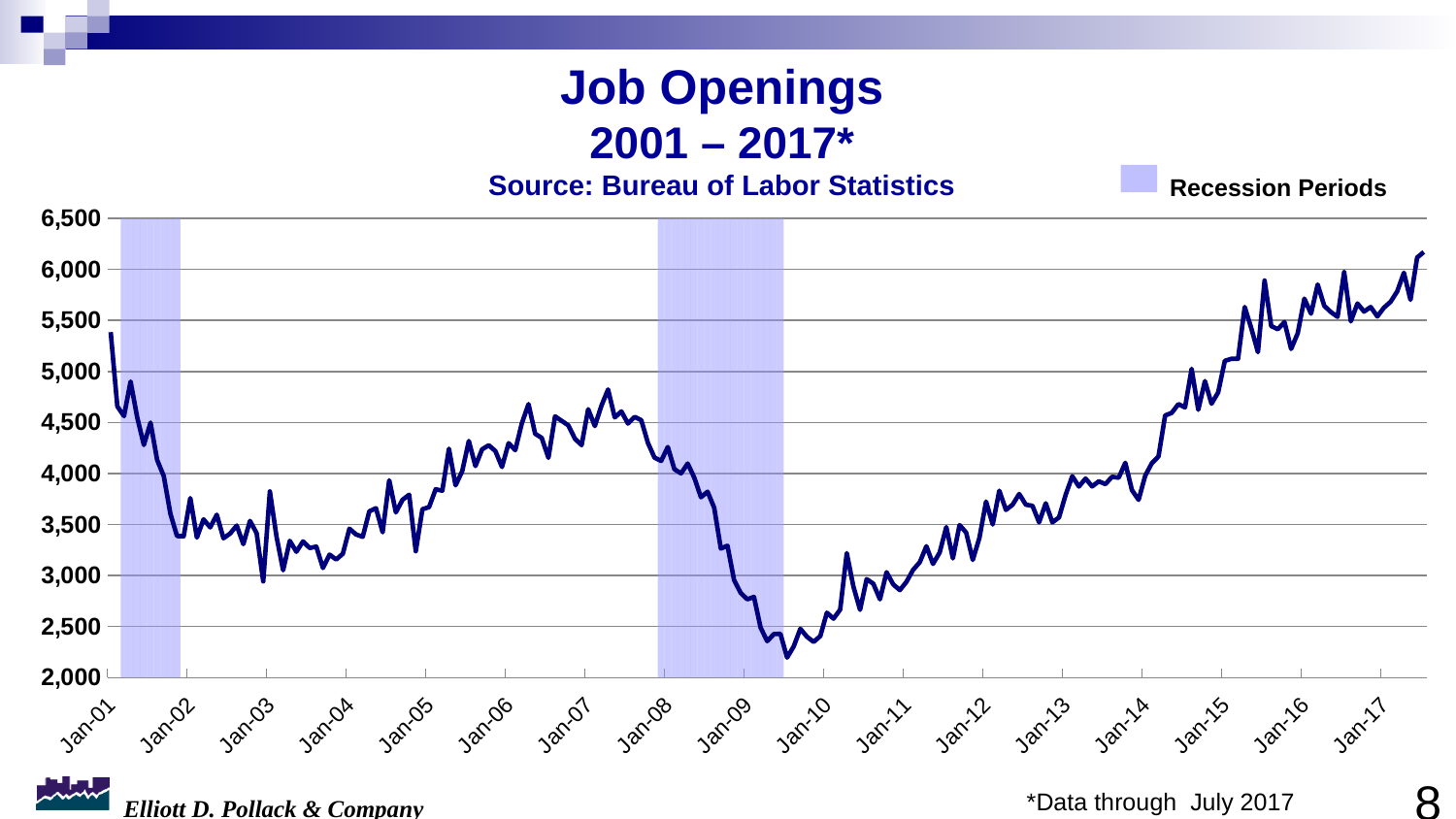
Is the value for Jan-17 greater or less than 5,000? greater What source is cited for the chart data? Bureau of Labor Statistics Is the value for Jan-10 greater or less than 3,000? less What kind of chart is shown on the slide? line chart Do job openings rise or fall between Jan-08 and Jan-10? fall Is the value for Jan-01 greater or less than 5,000? greater Do job openings rise or fall between Jan-10 and Jan-17? rise What is the title of the chart? Job Openings 2001 – 2017* How many shaded recession periods are shown on the chart? 2 In which year does the line reach its lowest point? 2009